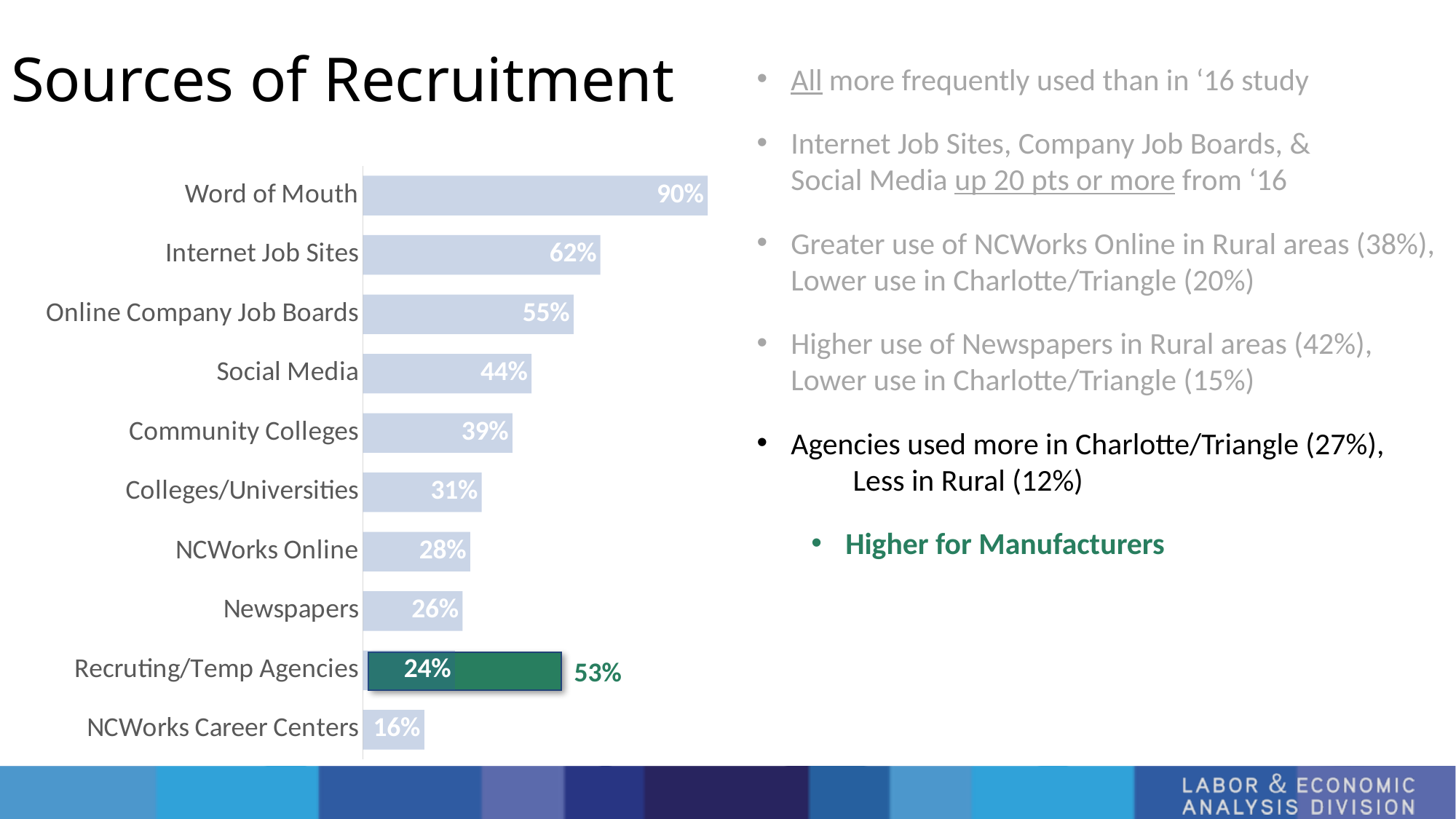
How many sources of recruitment are listed in the chart? 10 What is the green-labelled value shown next to the Recruiting/Temp Agencies bar? 53% Which source of recruitment has the highest value? Word of Mouth What is the value for Social Media? 44% What is the value for Word of Mouth? 90% Which source of recruitment has the lowest value? NCWorks Career Centers What kind of chart is shown on the slide? Bar chart What is the title of the slide containing the chart? Sources of Recruitment Which is larger, the value for Community Colleges or the value for Colleges/Universities? Community Colleges What is the value for NCWorks Online? 28% What is the difference between the values for Internet Job Sites and Online Company Job Boards? 7% What is the value for NCWorks Career Centers? 16%